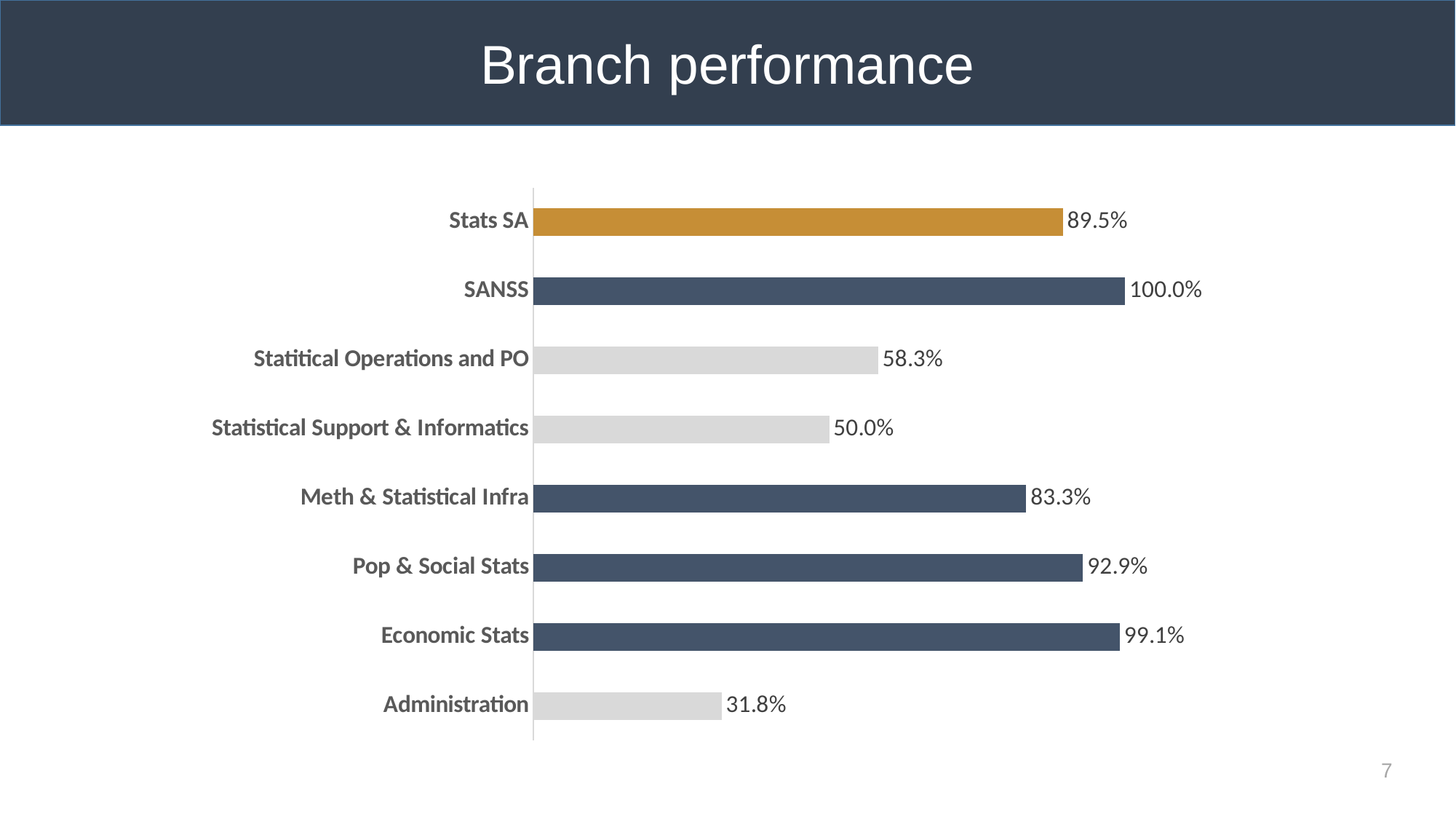
What is the value for Stats SA? 89.5% How many categories are shown in the chart? 8 What kind of chart is shown on the slide? Bar chart What is the difference between the values for Statitical Operations and PO and Administration? 26.5% What is the title of the slide containing the chart? Branch performance What is the value for Meth & Statistical Infra? 83.3% Which category has the highest value? SANSS Which is larger, the value for Pop & Social Stats or the value for Meth & Statistical Infra? Pop & Social Stats What is the difference between the values for Economic Stats and Pop & Social Stats? 6.2% What is the value for Administration? 31.8% Which category has the lowest value? Administration What is the value for Statistical Support & Informatics? 50.0%